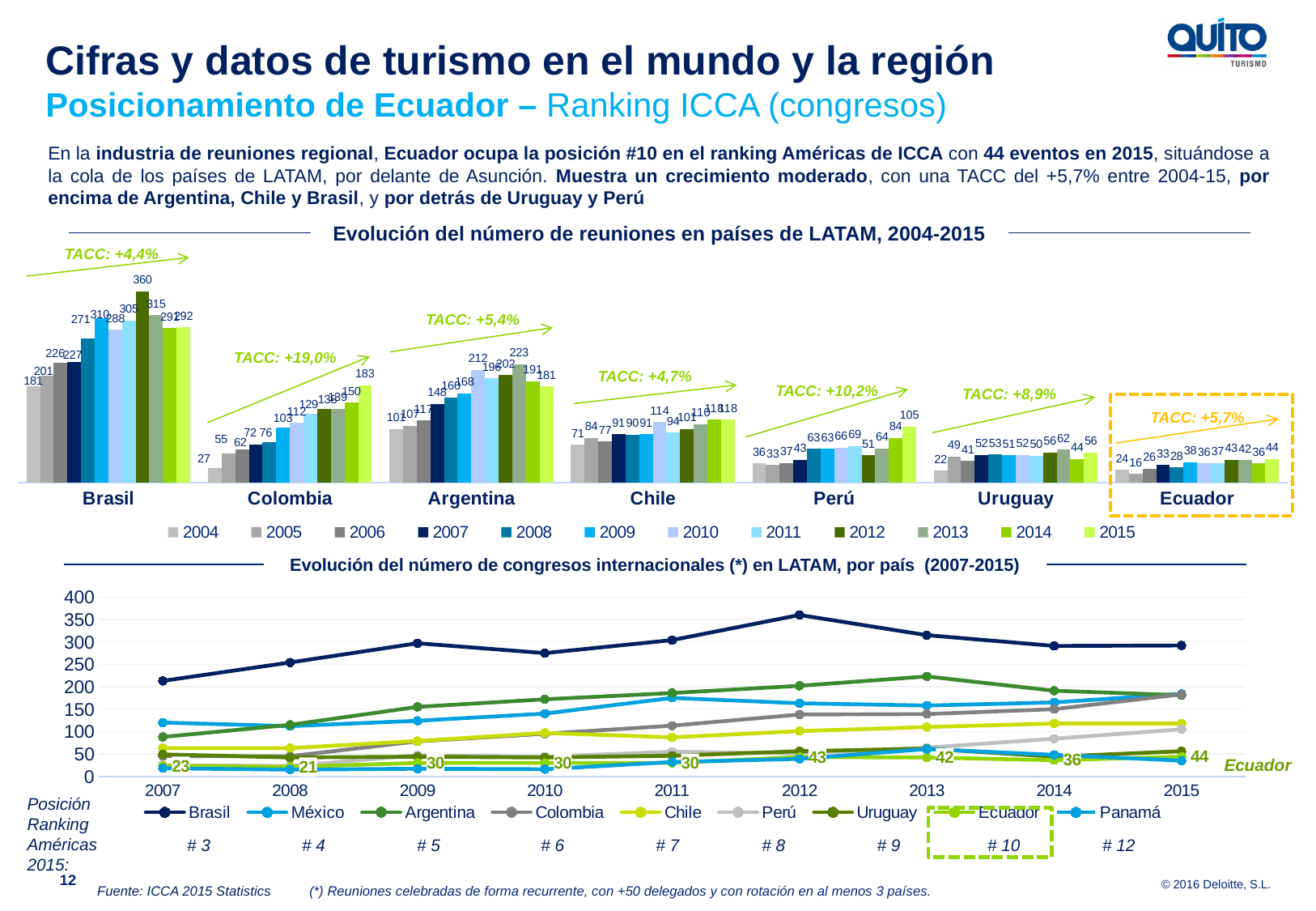
In the top chart 'Evolución del número de reuniones en países de LATAM', which year has the highest value for Brasil? 2012 What kind of chart is the bottom chart, 'Evolución del número de congresos internacionales (*) en LATAM, por país (2007-2015)'? Line chart In the top chart 'Evolución del número de reuniones en países de LATAM', which year has the lowest value for Ecuador? 2005 In the top chart 'Evolución del número de reuniones en países de LATAM', what TACC is shown for Colombia? +19,0% In the bottom chart 'Evolución del número de congresos internacionales en LATAM, por país', how many series does the legend list? 9 In the top chart 'Evolución del número de reuniones en países de LATAM', how many countries are shown on the x axis? 7 In the top chart 'Evolución del número de reuniones en países de LATAM', what is the value for Colombia in 2015? 183 In the bottom chart 'Evolución del número de congresos internacionales en LATAM, por país', is the value for Brasil in 2012 greater or less than 350? greater What kind of chart is the top chart, 'Evolución del número de reuniones en países de LATAM, 2004-2015'? Bar chart In the top chart 'Evolución del número de reuniones en países de LATAM', what is the value for Ecuador in 2015? 44 In the top chart 'Evolución del número de reuniones en países de LATAM', what is the difference between Ecuador's 2015 value and its 2004 value? 20 In the top chart 'Evolución del número de reuniones en países de LATAM', how many series does the legend list? 12